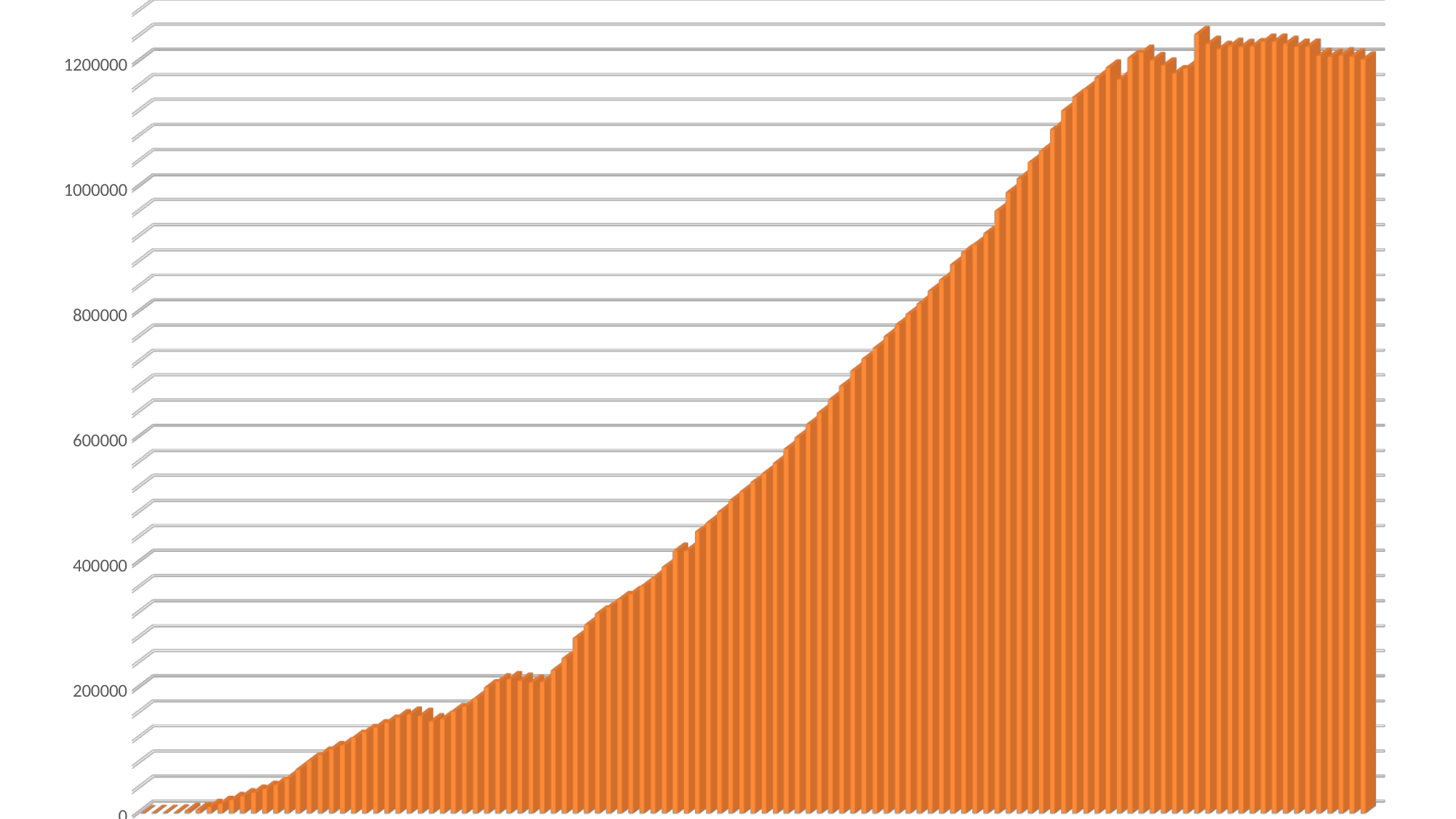
What kind of chart is shown on the slide? bar chart What colour are the bars in the chart? orange What is the highest labelled tick on the vertical axis? 1200000 Do the values generally rise or fall from left to right along the x axis? rise